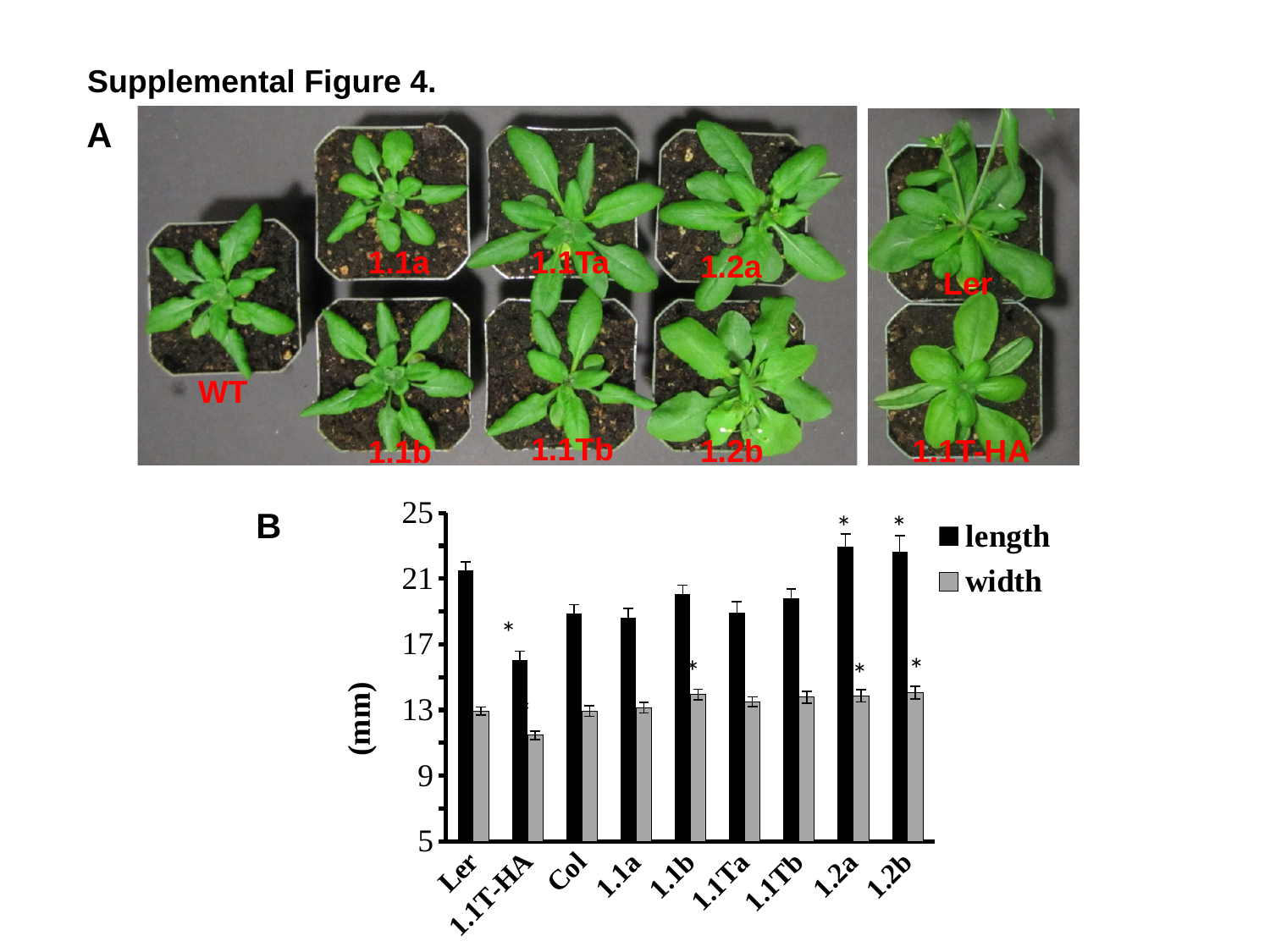
In the chart in panel B, which category has the lowest width value? 1.1T-HA What kind of chart is shown in panel B? bar chart In the chart in panel B, is the width value for 1.1T-HA greater or less than 13? less In the chart in panel B, is the length value for 1.1T-HA greater or less than 17? less In the chart in panel B, which category has the lowest length value? 1.1T-HA What is the y-axis label of the chart in panel B? (mm) How many categories are shown on the x axis of the chart in panel B? 9 In the chart in panel B, is the length value for 1.2a greater or less than 21? greater In the chart in panel B, which is larger: the length value for 1.1T-HA or the length value for Col? Col How many series does the legend of the chart in panel B list? 2 In the chart in panel B, which is larger: the length value for Ler or the length value for Col? Ler